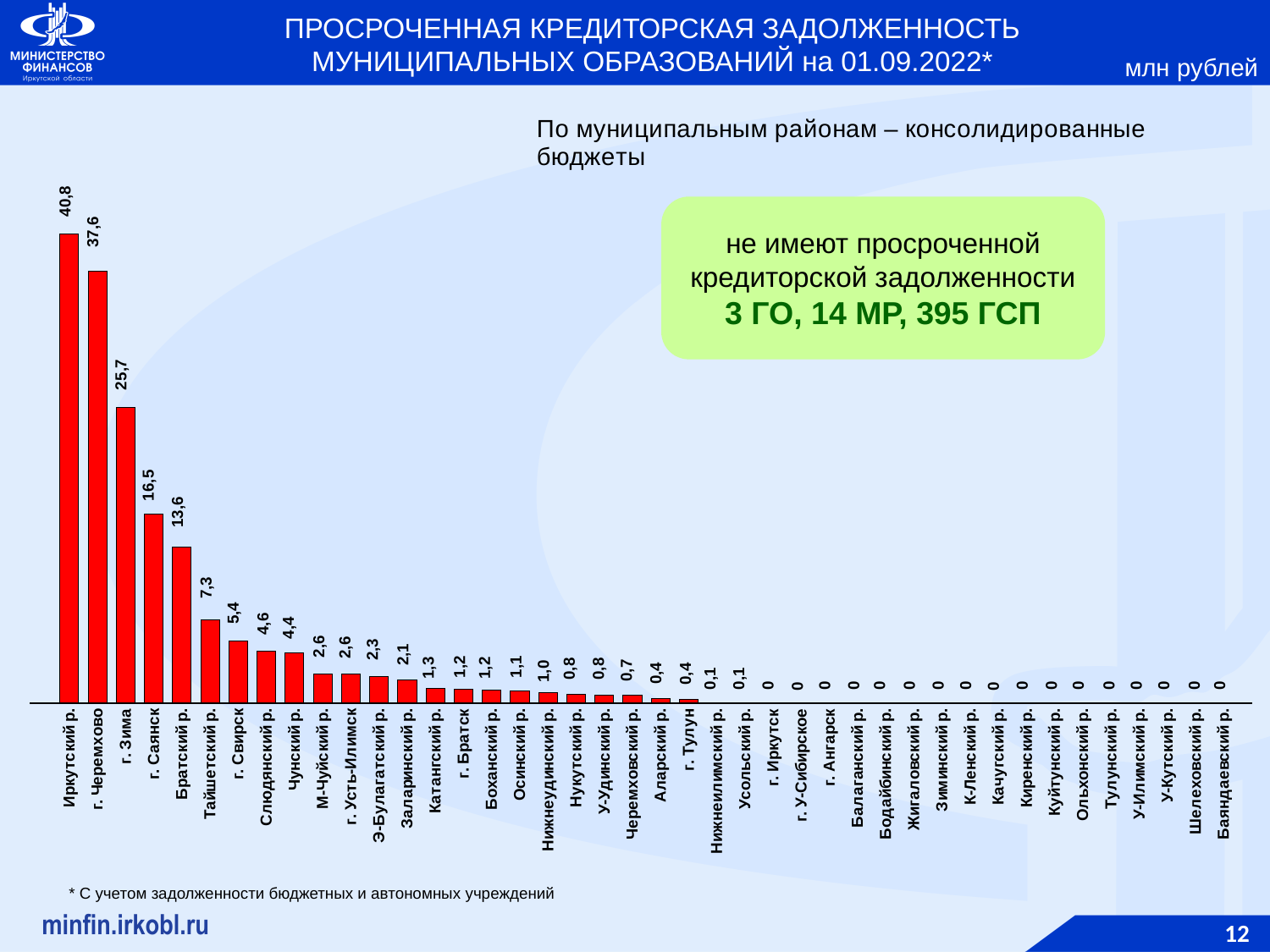
Do the values rise or fall from left to right along the x axis? fall What is the difference between the values for г. Саянск and Братский р.? 2,9 What is the value for г. Зима? 25,7 Which category has the highest value? Иркутский р. What unit is shown for the chart values? млн рублей What is the value for Катангский р.? 1,3 What kind of chart is shown on the slide? bar chart What is the difference between the values for Иркутский р. and г. Черемхово? 3,2 What is the value for Тайшетский р.? 7,3 What is the value for Иркутский р.? 40,8 Which is larger, the value for г. Свирск or the value for Слюдянский р.? г. Свирск How many categories have a value of 0? 17